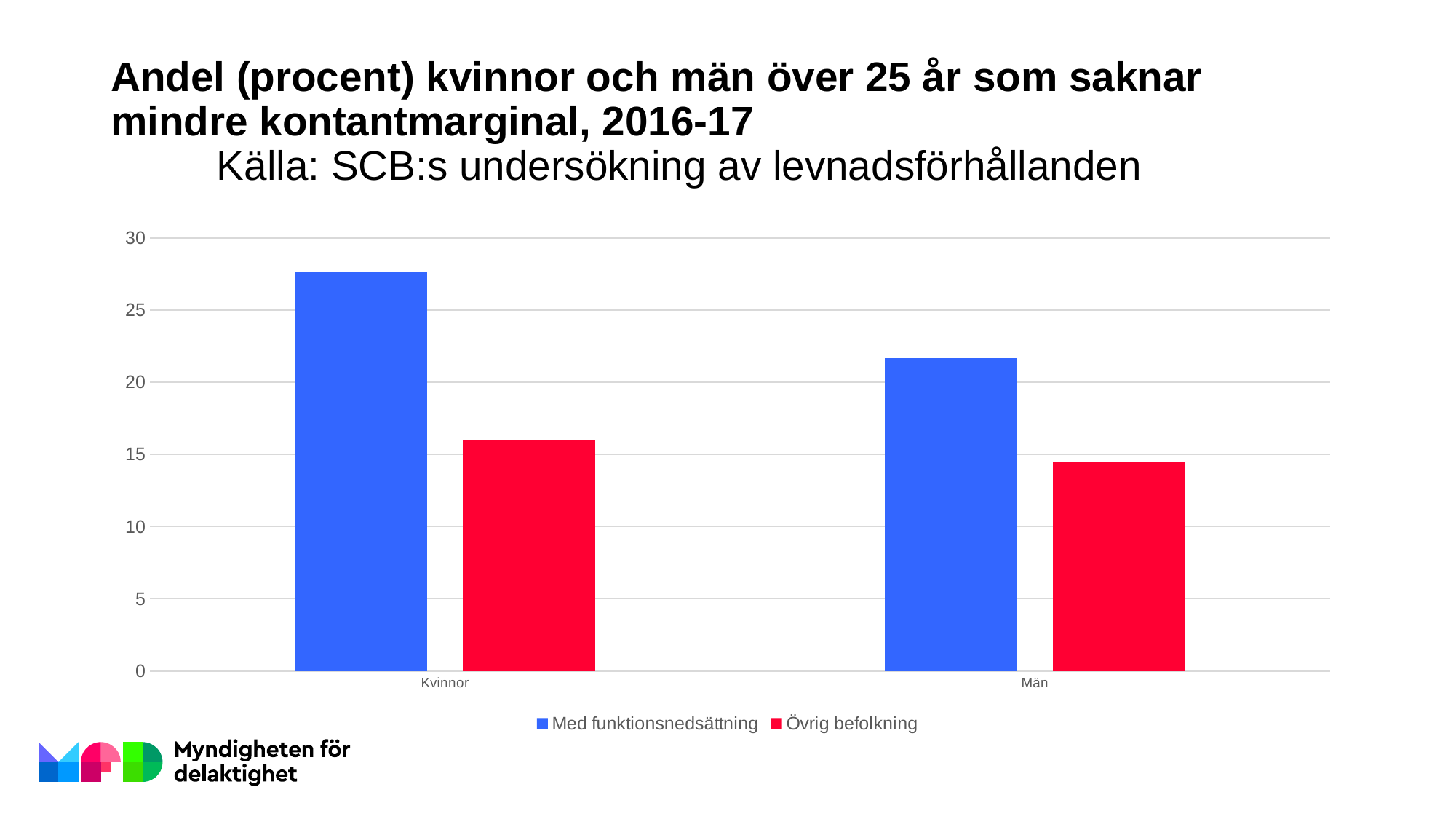
How many categories are shown on the x axis? 2 Is the value for Övrig befolkning among Kvinnor greater or less than 20? less Is the value for Med funktionsnedsättning among Män greater or less than 20? greater How many series does the legend list? 2 Which bar is the lowest in the chart? Övrig befolkning, Män Which series is shown in blue? Med funktionsnedsättning Is the value for Övrig befolkning among Män greater or less than 10? greater Which series is shown in red? Övrig befolkning Which bar is the highest in the chart? Med funktionsnedsättning, Kvinnor Which category has the higher value for Med funktionsnedsättning, Kvinnor or Män? Kvinnor What kind of chart is shown on the slide? bar chart